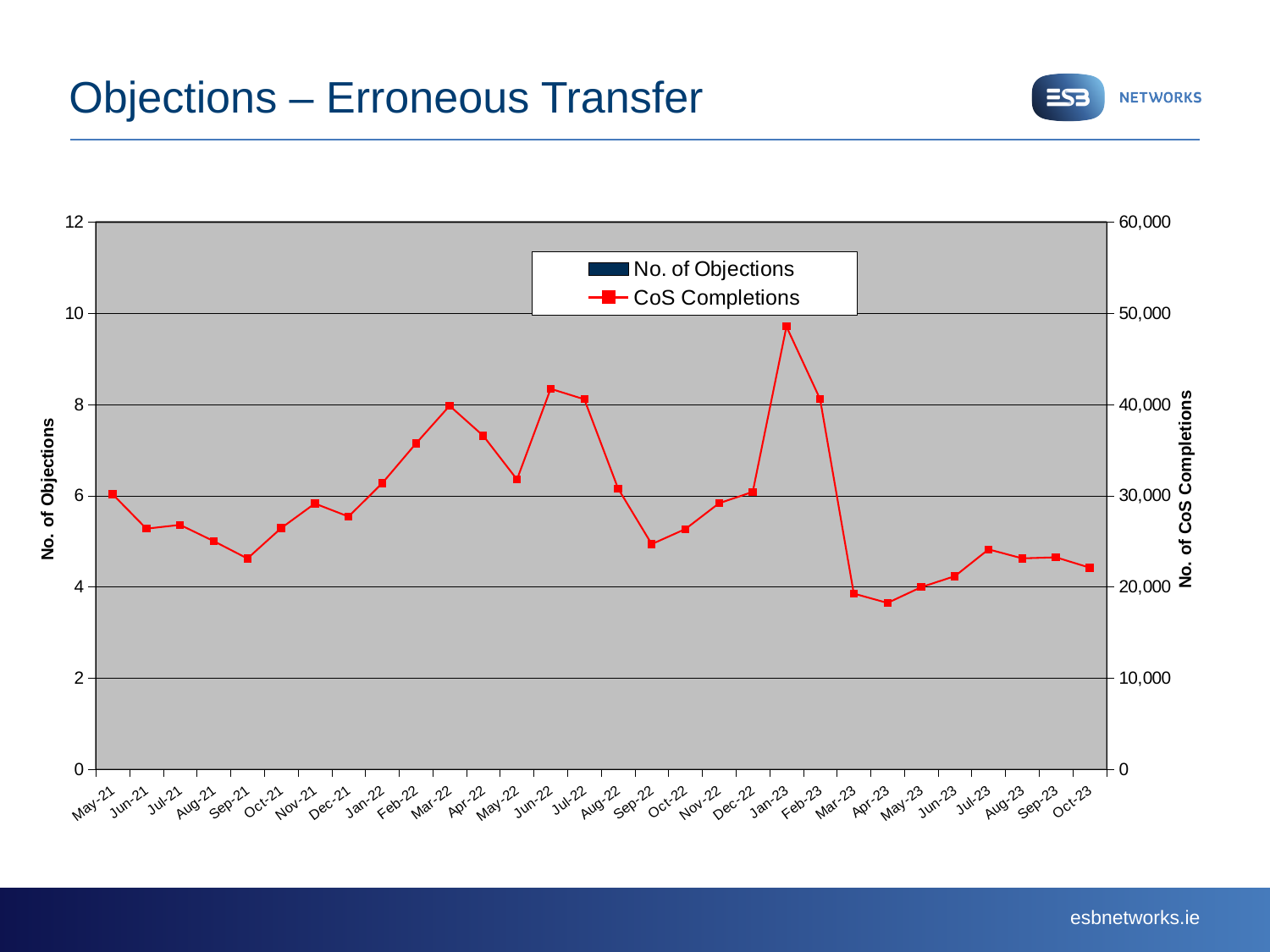
Is the CoS Completions value for Jan-23 greater or less than 40,000? greater Is the CoS Completions value for Apr-23 greater or less than 20,000? less How many months are shown along the x axis? 30 Which month has the larger CoS Completions value, Mar-22 or Sep-22? Mar-22 In which month is the CoS Completions value highest? Jan-23 What colour is the CoS Completions line? Red What kind of chart is shown on the slide? Line chart What is the title of the right-hand vertical axis? No. of CoS Completions How many series does the legend list? 2 Is the CoS Completions value for Sep-21 greater or less than 30,000? less In which month is the CoS Completions value lowest? Apr-23 Do the CoS Completions values rise or fall from Jan-23 to Mar-23? Fall